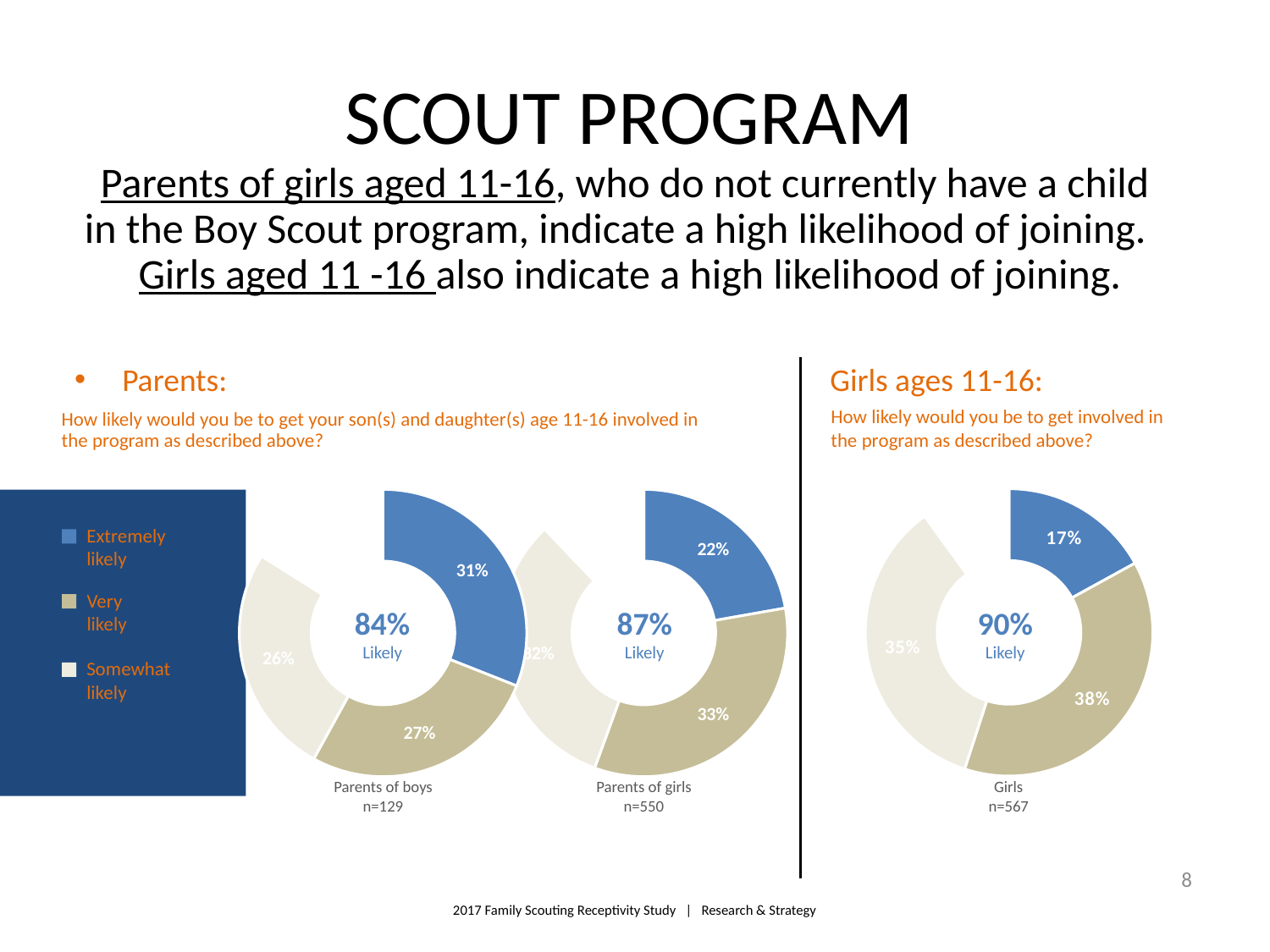
In the Parents of girls chart, what percentage are very likely? 33% In the Girls chart, what percentage are somewhat likely? 35% In the Parents of girls chart, what percentage are extremely likely? 22% In the Parents of boys chart, what percentage are somewhat likely? 26% In the Girls chart, what percentage of girls are very likely to get involved? 38% In the Girls chart, which response category has the smallest share? Extremely likely In the Parents of boys chart, what percentage are very likely? 27% How many response categories does the legend list? 3 In the Parents of boys chart, which response category has the largest share? Extremely likely What is the overall 'Likely' percentage shown in the centre of the Girls chart? 90% In the Parents of boys chart, what percentage of parents are extremely likely to get their children involved? 31% What is the difference between the 'Likely' total for Parents of girls and the 'Likely' total for Parents of boys? 3%